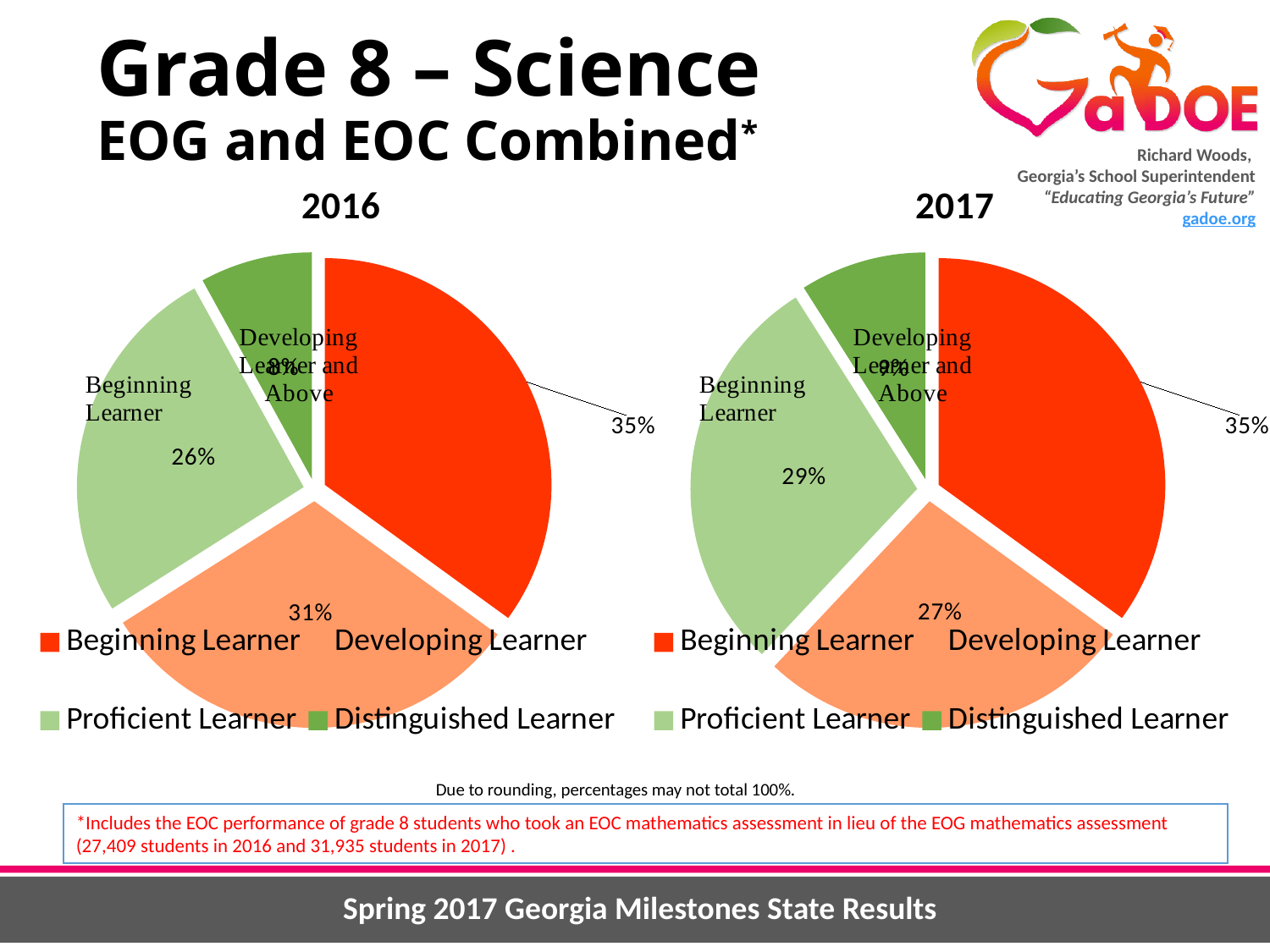
In the 2017 pie chart, which is larger: the Proficient Learner share or the Developing Learner share? Proficient Learner In the 2016 pie chart, what percentage of students were Developing Learners? 31% In the 2017 pie chart, what percentage of students were Beginning Learners? 35% In the 2016 pie chart, what percentage of students were Beginning Learners? 35% In the 2016 pie chart, how many percentage points larger is the Beginning Learner share than the Developing Learner share? 4 percentage points In the 2017 pie chart, which category has the smallest slice? Distinguished Learner In the 2017 pie chart, what percentage of students were Proficient Learners? 29% In the 2017 pie chart, what percentage of students were Developing Learners? 27% In the 2016 pie chart, what percentage of students were Proficient Learners? 26% How many categories does the legend of the 2017 pie chart list? 4 What type of chart is used to show the 2016 and 2017 results on this slide? Pie chart In the 2016 pie chart, which category has the largest slice? Beginning Learner